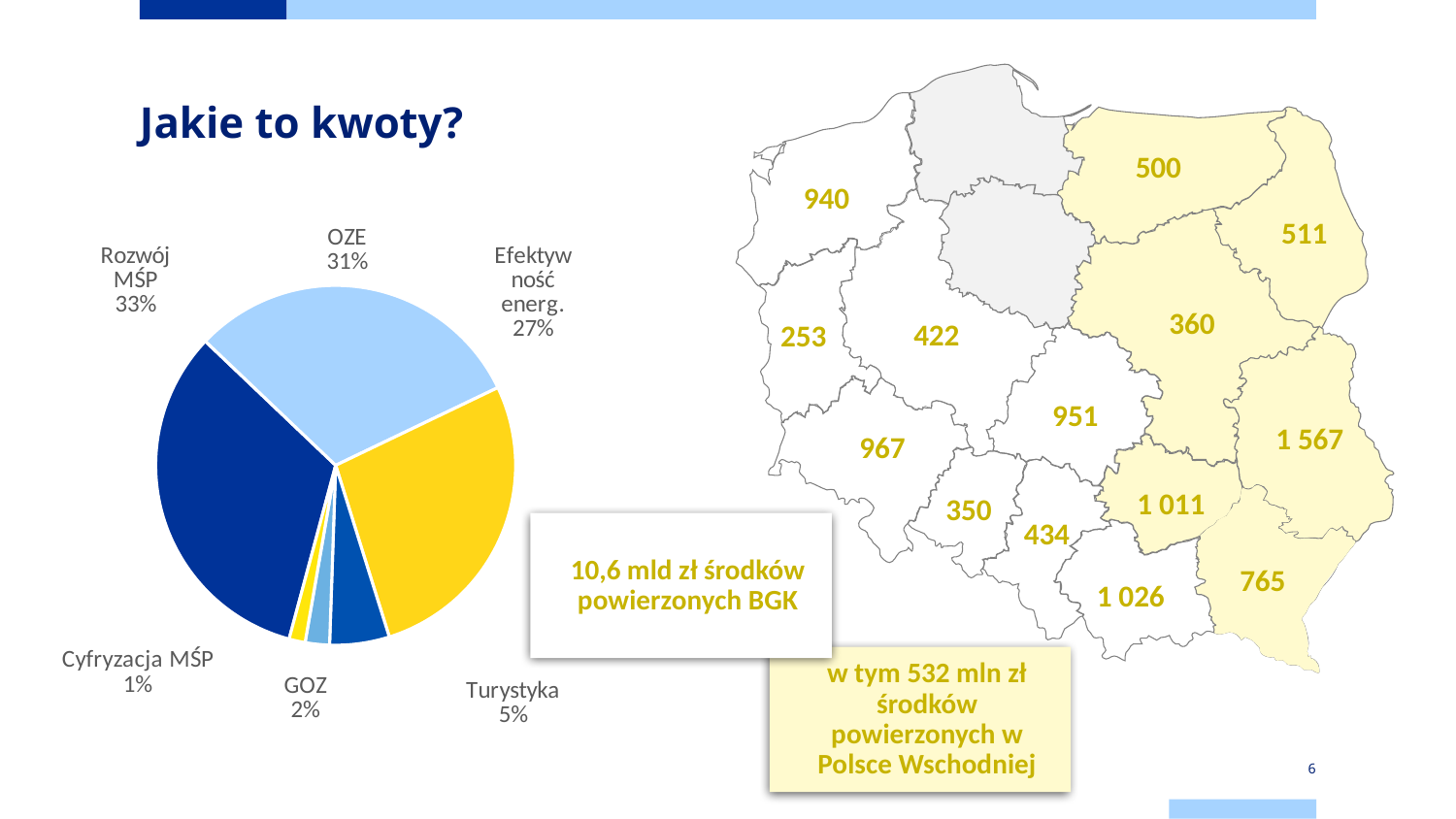
What is the difference in percentage points between the OZE slice and the Turystyka slice? 26 In the pie chart, what share does Cyfryzacja MŚP have? 1% In the pie chart, what share does Efektywność energ. have? 27% What kind of chart is shown on the left of the slide? pie chart In the pie chart, what share does Turystyka have? 5% Which is larger in the pie chart, Efektywność energ. or Turystyka? Efektywność energ. How many slices does the pie chart have? 6 In the pie chart, what share does GOZ have? 2% Which slice of the pie chart is the largest? Rozwój MŚP In the pie chart, what share does OZE have? 31% In the pie chart, what share does Rozwój MŚP have? 33% Which slice of the pie chart is the smallest? Cyfryzacja MŚP